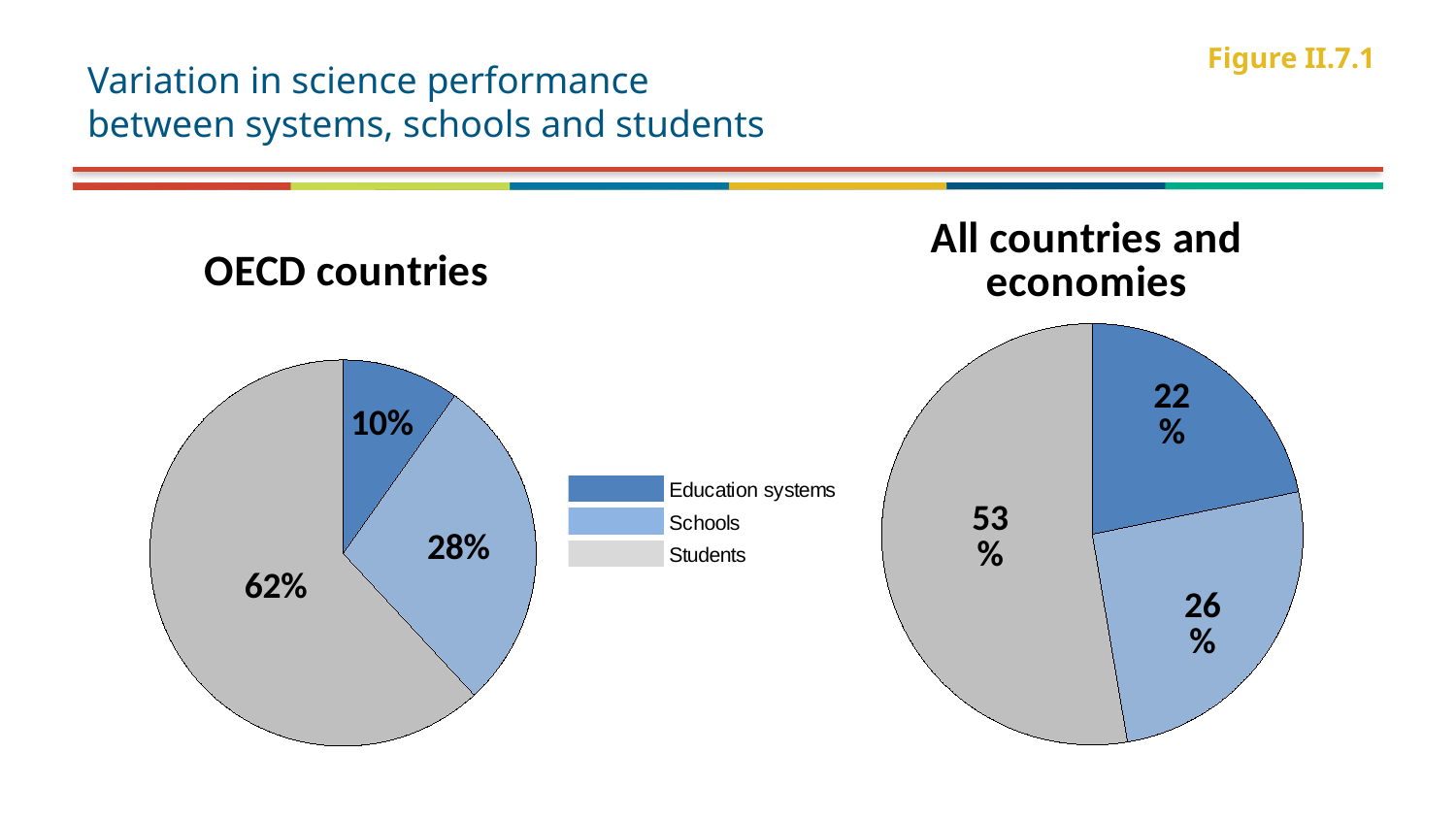
How many categories does the legend list? 3 What is the title of the chart on the left? OECD countries In the All countries and economies pie chart, what share is attributed to Students? 53% In the All countries and economies pie chart, what share is attributed to Education systems? 22% In the OECD countries pie chart, which category has the smallest slice? Education systems What type of chart is used on this slide? Pie chart In the OECD countries pie chart, what is the difference between the Students share and the Schools share? 34 percentage points In the OECD countries pie chart, what share is attributed to Schools? 28% In the OECD countries pie chart, what share is attributed to Education systems? 10% In the All countries and economies pie chart, which category has the largest slice? Students Is the Education systems share larger in the OECD countries chart or in the All countries and economies chart? All countries and economies In the OECD countries pie chart, what share is attributed to Students? 62%